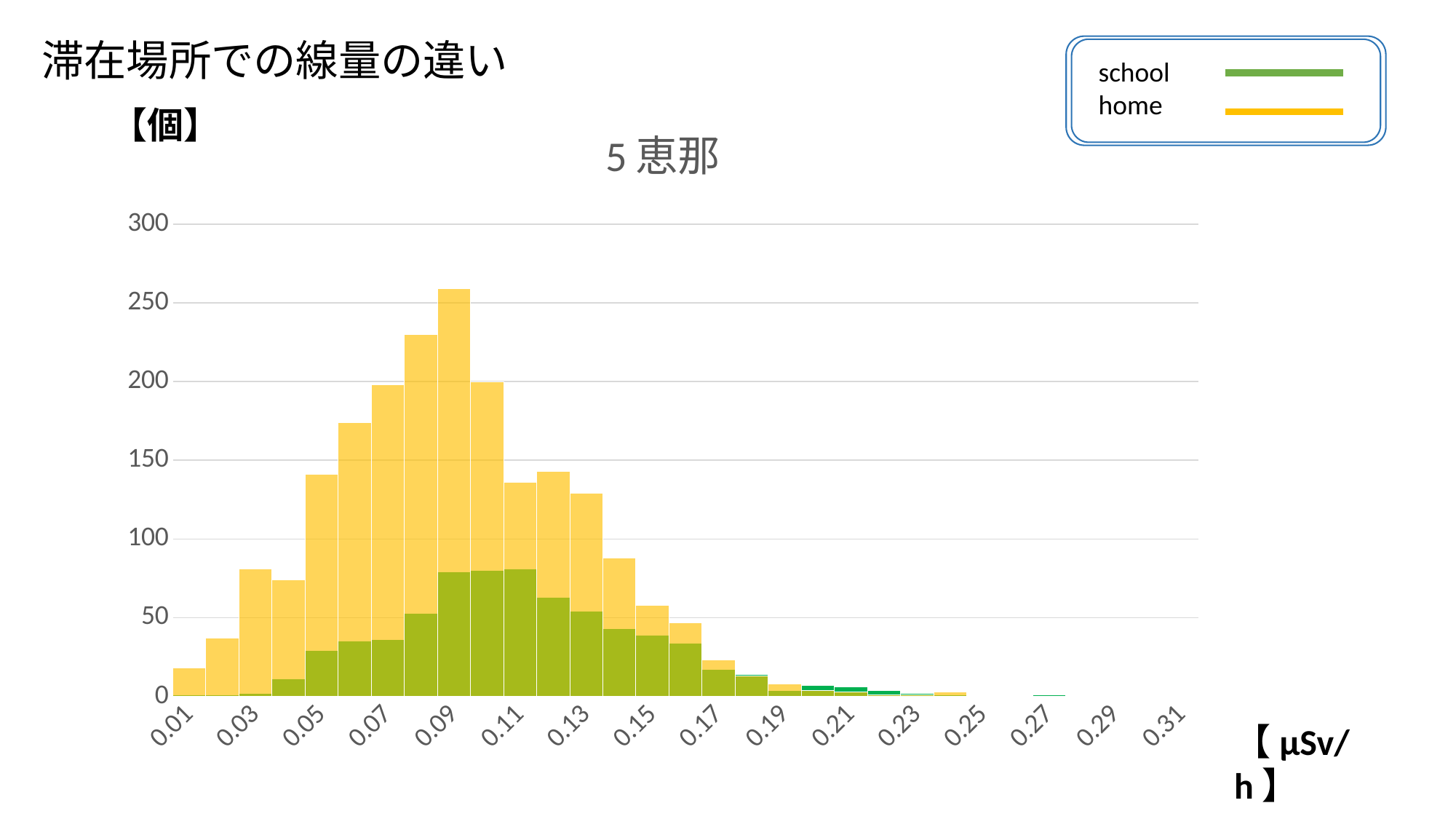
Which colour represents the home series in the legend? yellow Is the school value at 0.11 greater or less than 50? greater What is the title of the chart? 5 恵那 What kind of chart is shown on the slide? bar chart Do the home values rise or fall along the x axis from 0.09 to 0.17? fall At which x-axis value does the home series reach its highest bar? 0.09 Is the home value at 0.09 greater or less than 250? greater Is the school value at 0.07 greater or less than 50? less At 0.09, which series has the larger value, school or home? home How many series does the legend list? 2